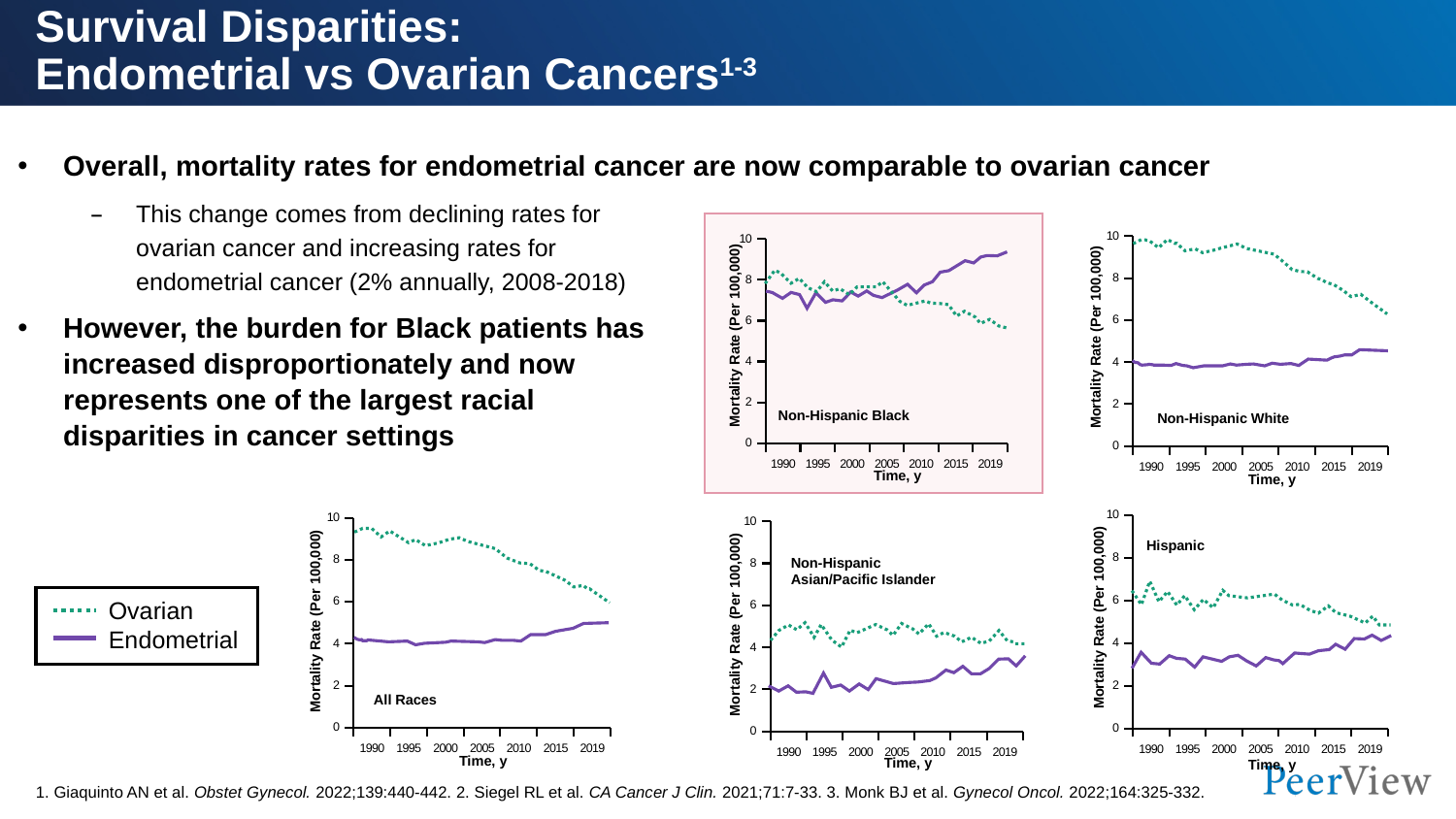
What kind of chart is the 'All Races' chart? Line chart How many charts are shown on the slide? 5 In the 'Hispanic' chart, does the Ovarian mortality rate rise or fall over time? Fall How many series does the legend list? 2 In the 'All Races' chart, is the Ovarian value in 1990 greater or less than 8? Greater In the 'Non-Hispanic White' chart, is the Endometrial value in 1990 greater or less than 6? Less What are the two series named in the legend? Ovarian and Endometrial In the 'Non-Hispanic Black' chart, does the Endometrial mortality rate rise or fall from 1990 to 2019? Rise In the 'Non-Hispanic Black' chart, which series has the higher value in 2019, Ovarian or Endometrial? Endometrial In the 'Non-Hispanic Asian/Pacific Islander' chart, is the Endometrial value in 1990 greater or less than 4? Less In the 'Hispanic' chart, which series has the higher value in 1990, Ovarian or Endometrial? Ovarian In the 'Non-Hispanic White' chart, does the Ovarian mortality rate rise or fall from 1990 to 2019? Fall